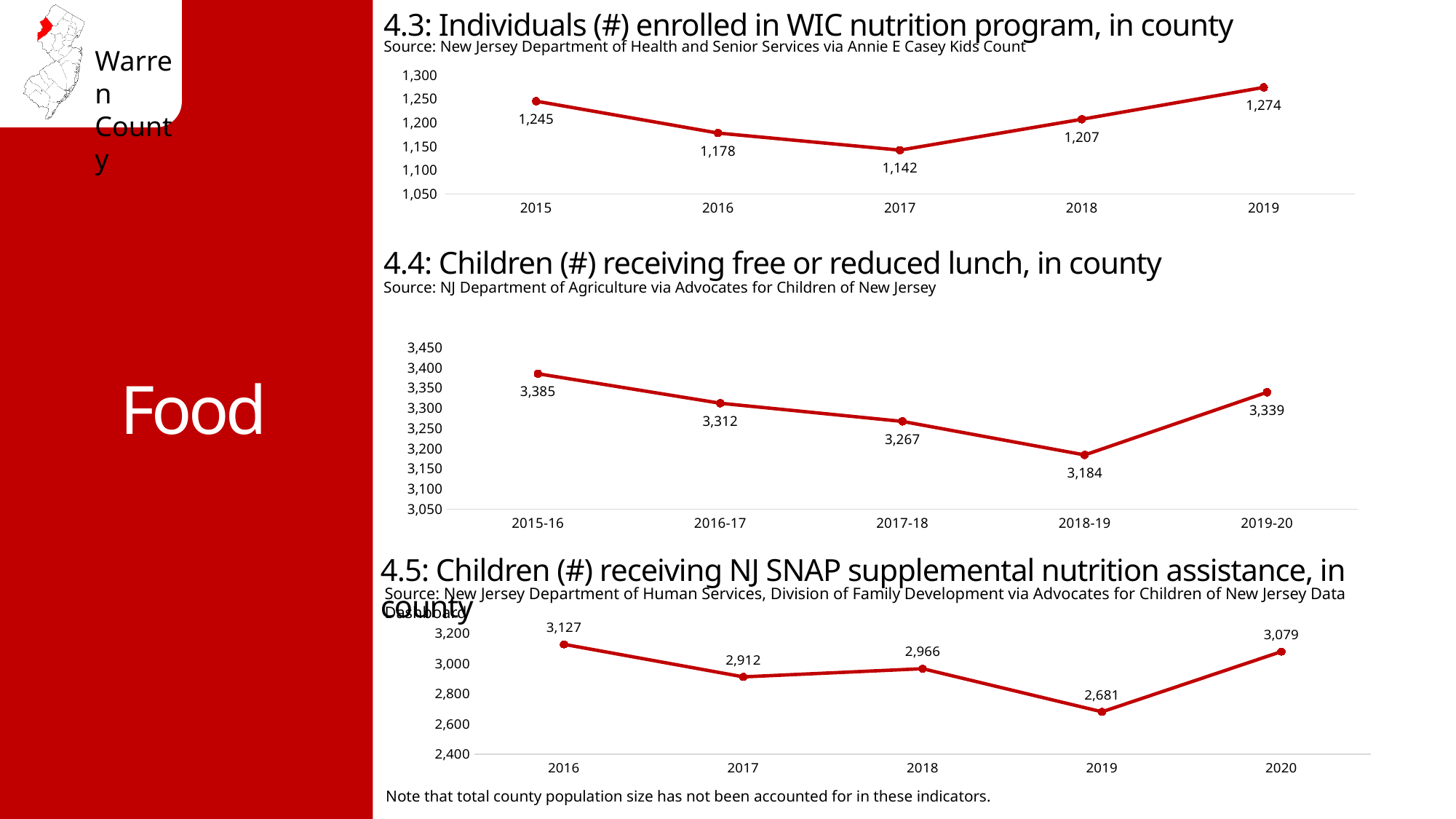
In the chart '4.5: Children (#) receiving NJ SNAP supplemental nutrition assistance, in county', which year has the lowest value? 2019 In the chart '4.3: Individuals (#) enrolled in WIC nutrition program, in county', what is the difference between the 2019 and 2015 values? 29 In the chart '4.4: Children (#) receiving free or reduced lunch, in county', is the value for 2015-16 larger or smaller than the value for 2019-20? larger In the chart '4.4: Children (#) receiving free or reduced lunch, in county', what kind of chart is shown? line chart In the chart '4.5: Children (#) receiving NJ SNAP supplemental nutrition assistance, in county', what is the difference between the 2016 and 2019 values? 446 In the chart '4.5: Children (#) receiving NJ SNAP supplemental nutrition assistance, in county', is the value for 2019 greater or less than 2,800? less In the chart '4.3: Individuals (#) enrolled in WIC nutrition program, in county', what is the value for 2017? 1,142 In the chart '4.4: Children (#) receiving free or reduced lunch, in county', what is the value for 2018-19? 3,184 In the chart '4.3: Individuals (#) enrolled in WIC nutrition program, in county', how many data points are plotted? 5 In the chart '4.3: Individuals (#) enrolled in WIC nutrition program, in county', which year has the highest value? 2019 In the chart '4.4: Children (#) receiving free or reduced lunch, in county', which school year has the lowest value? 2018-19 In the chart '4.5: Children (#) receiving NJ SNAP supplemental nutrition assistance, in county', what is the value for 2020? 3,079